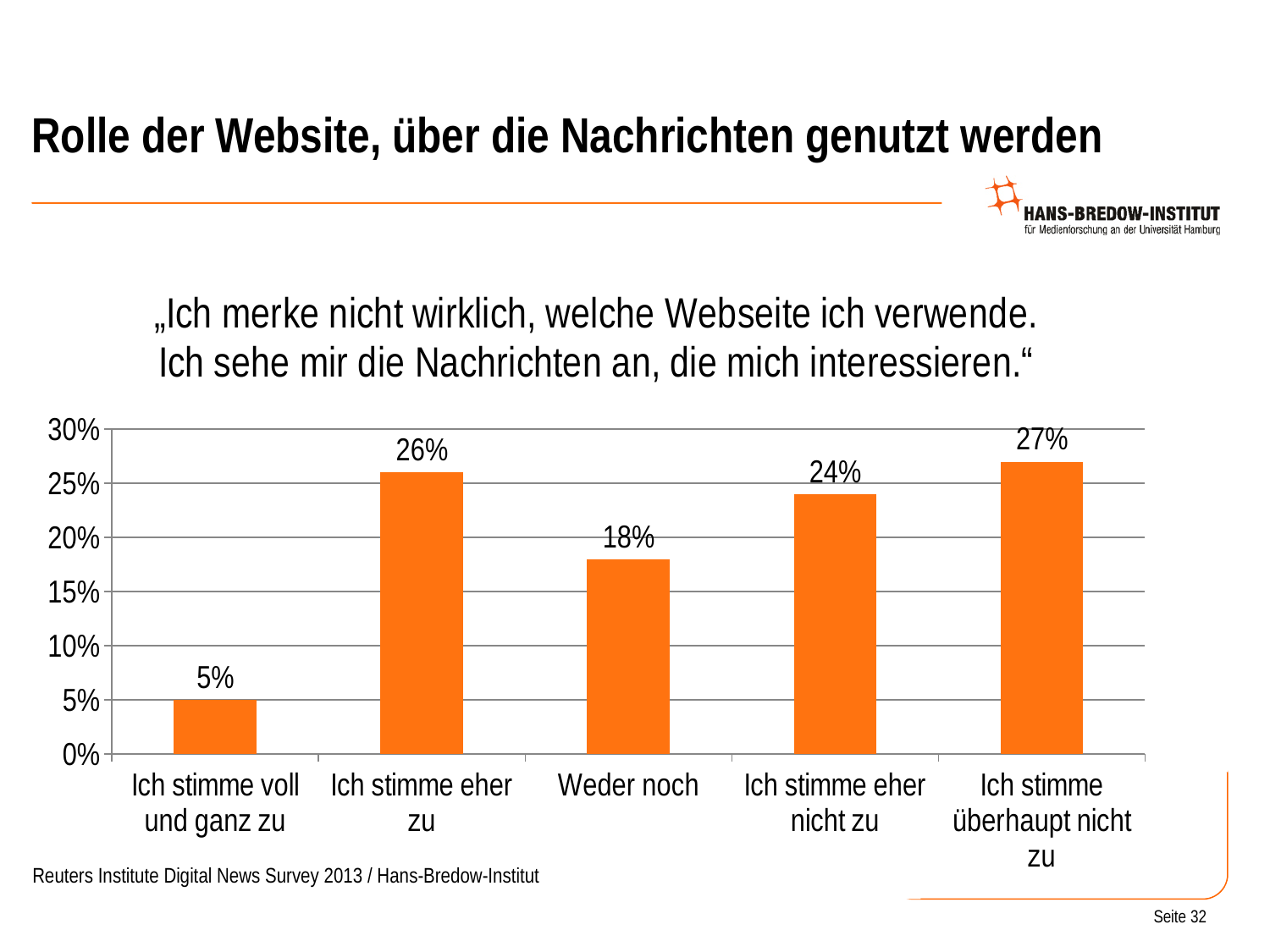
What is the source cited below the chart? Reuters Institute Digital News Survey 2013 / Hans-Bredow-Institut What is the value for "Weder noch"? 18% How many categories are shown on the x axis? 5 What is the value for "Ich stimme voll und ganz zu"? 5% Which is larger, the value for "Ich stimme eher zu" or the value for "Ich stimme eher nicht zu"? Ich stimme eher zu Which category has the highest value? Ich stimme überhaupt nicht zu Is the value for "Weder noch" greater or less than 20%? less What is the difference between "Ich stimme eher zu" and "Weder noch"? 8% What kind of chart is shown on the slide? bar chart Which category has the lowest value? Ich stimme voll und ganz zu What is the value for "Ich stimme eher nicht zu"? 24% What is the difference between "Ich stimme überhaupt nicht zu" and "Ich stimme voll und ganz zu"? 22%